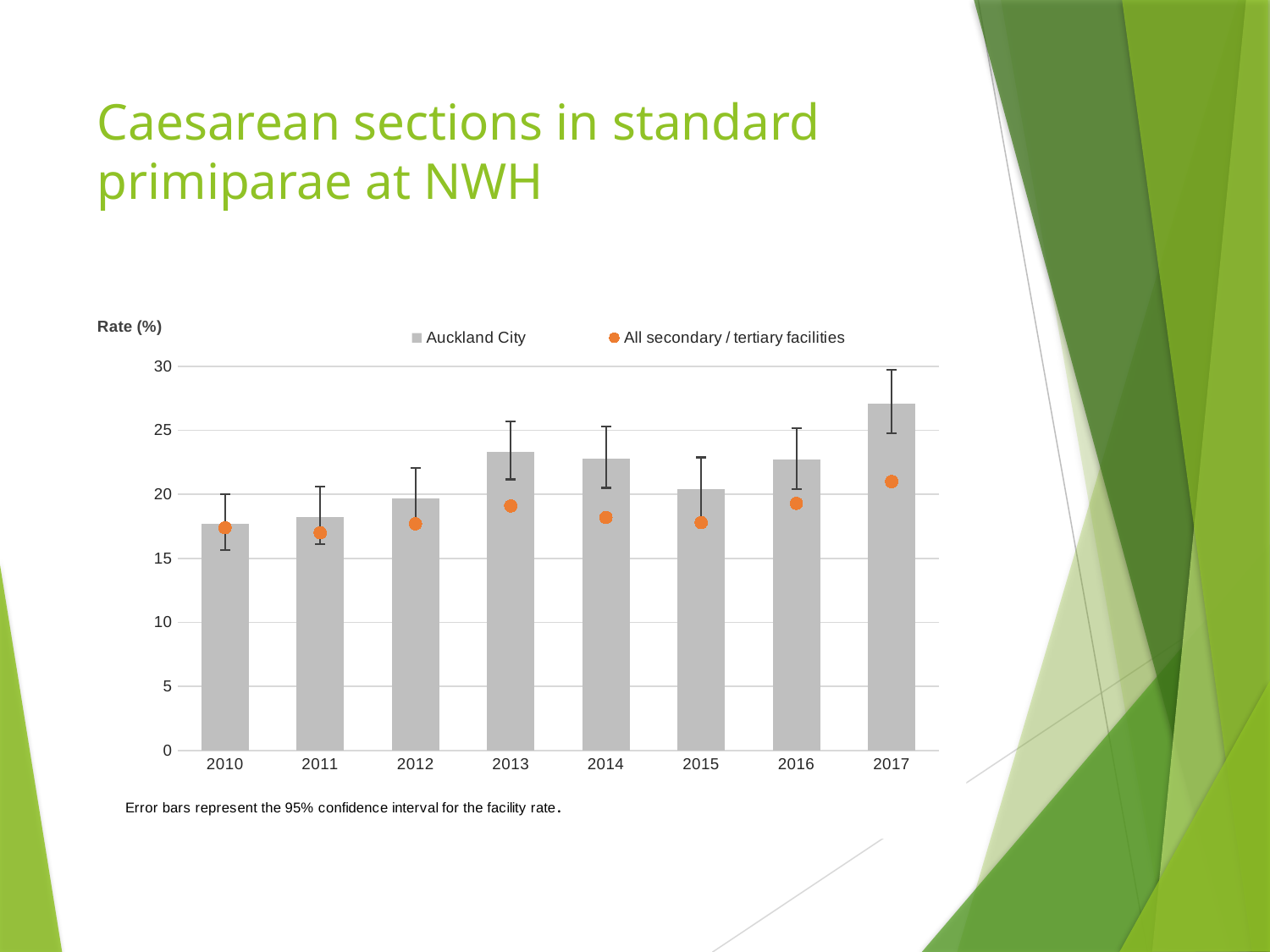
Is the All secondary / tertiary facilities value for 2015 greater or less than 20? less How many years are shown on the x axis? 8 Which year has the lowest Auckland City rate? 2010 What kind of chart is shown on the slide? bar chart Is the Auckland City rate for 2010 greater or less than 20? less Which is larger, the Auckland City rate for 2013 or for 2015? 2013 Which year has the highest value for All secondary / tertiary facilities? 2017 Is the Auckland City rate for 2017 greater or less than 25? greater How many series does the legend list? 2 Which year has the highest Auckland City rate? 2017 Do the Auckland City rates generally rise or fall from 2010 to 2017? rise What is the label on the vertical axis? Rate (%)